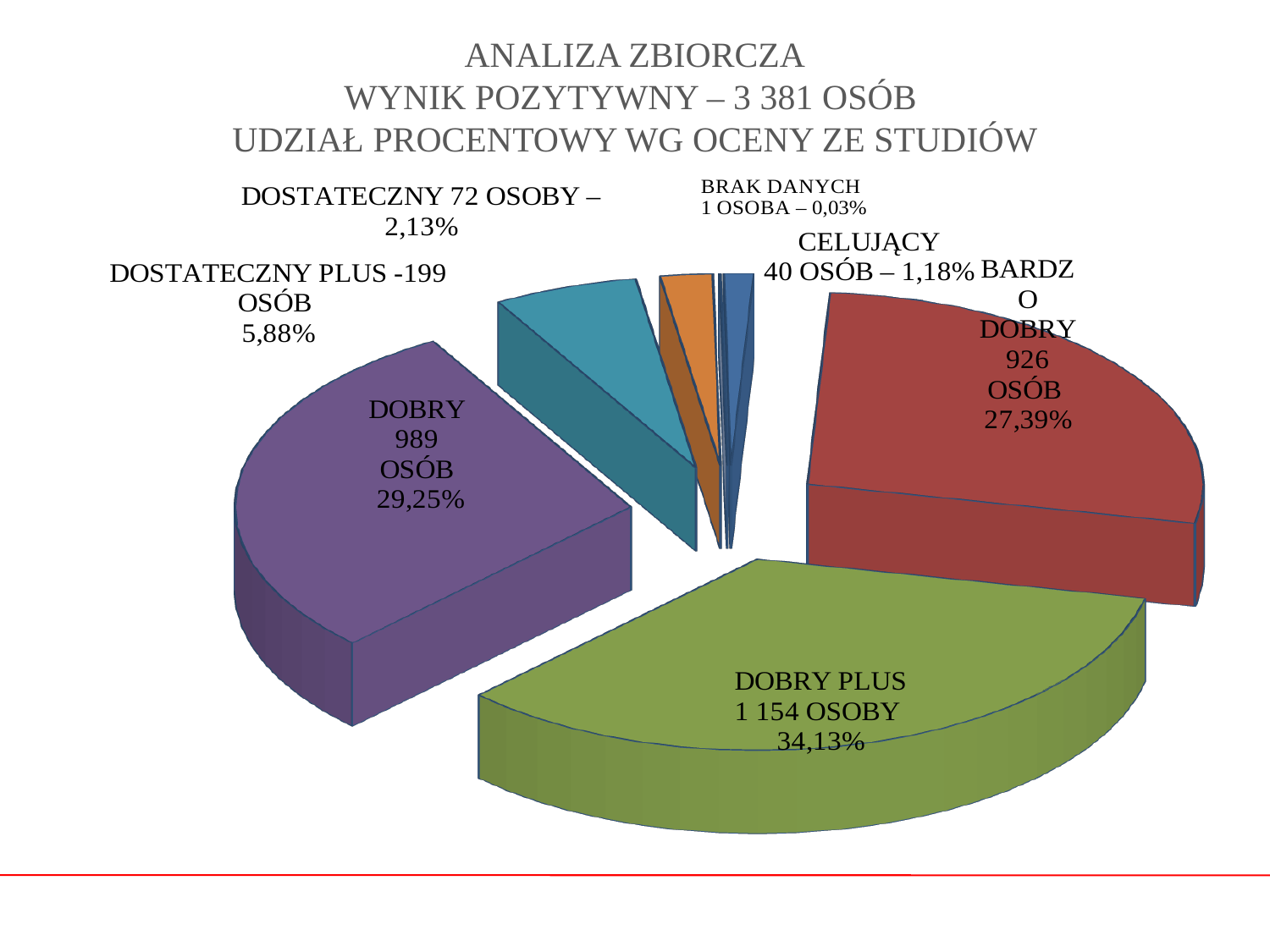
What total number of people with a positive result is stated in the chart title? 3 381 What kind of chart is shown on the slide? pie chart How many people are in the BARDZO DOBRY category? 926 What percentage share does the DOSTATECZNY PLUS slice have? 5,88% Which category has the smallest share of the pie? BRAK DANYCH What percentage share does the DOBRY PLUS slice have? 34,13% How many slices does the pie chart have? 7 Which is larger, the share for DOBRY or the share for BARDZO DOBRY? DOBRY How many people are in the CELUJĄCY category? 40 What is the difference in percentage points between the DOBRY PLUS share and the DOBRY share? 4,88 How many more people are in the DOBRY category than in the BARDZO DOBRY category? 63 Which category has the largest share of the pie? DOBRY PLUS